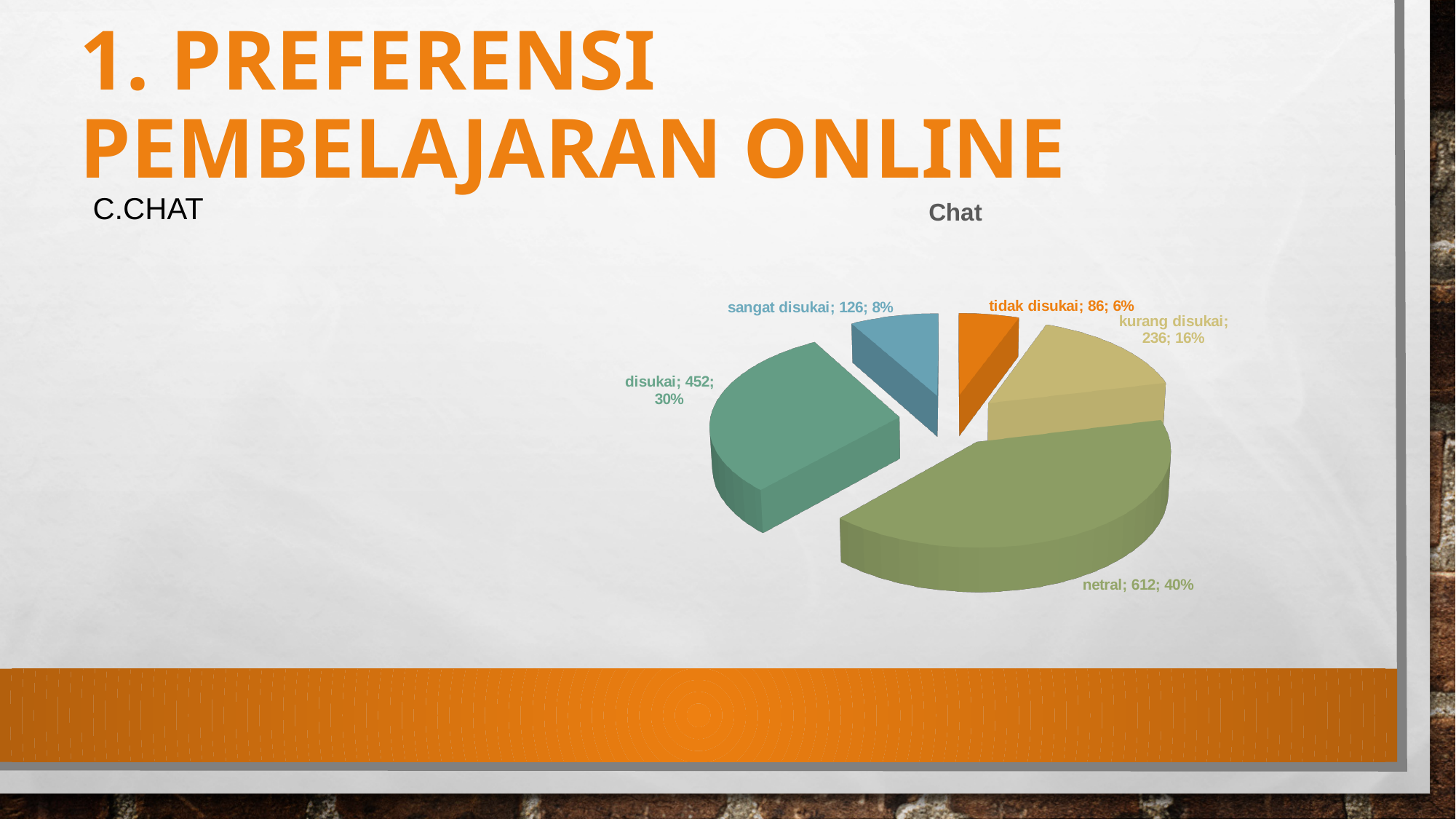
What is the value for kurang disukai? 236 Which is larger, the value for kurang disukai or the value for sangat disukai? kurang disukai What is the value for netral? 612 What kind of chart is shown on the slide? pie chart Which category has the largest slice? netral What is the value for tidak disukai? 86 Which category has the smallest slice? tidak disukai What is the value for disukai? 452 How many slices does the pie chart have? 5 What is the title of the chart? Chat What share of the pie does sangat disukai represent? 8% What is the difference between the values for netral and disukai? 160